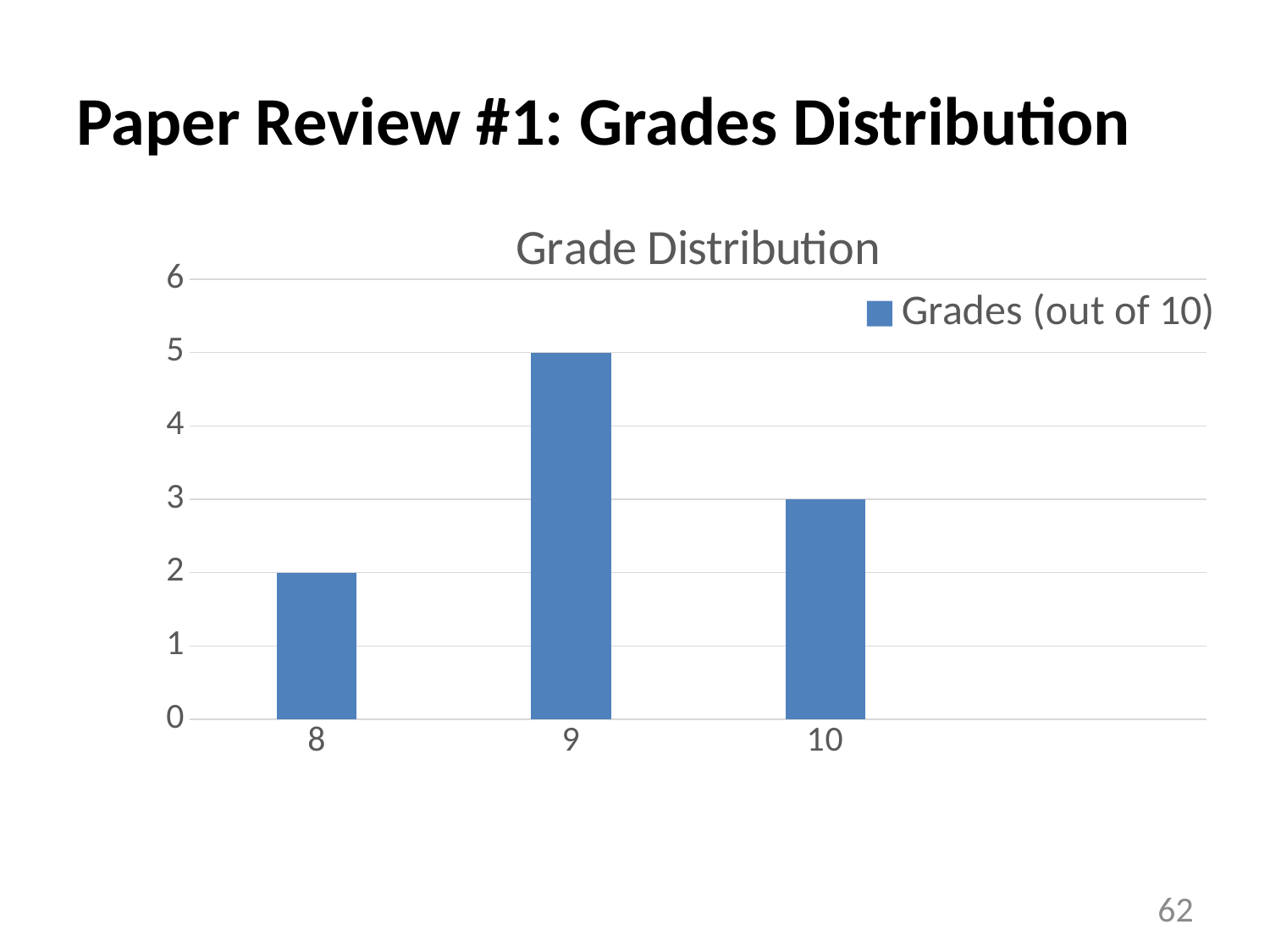
What kind of chart is shown on the slide? bar chart How many series does the legend list? 1 What is the value for grade 8 in the Grade Distribution chart? 2 Which grade has the lowest bar in the Grade Distribution chart? 8 Is the value for grade 9 greater or less than 4? greater What is the value for grade 10 in the Grade Distribution chart? 3 Which grade has the highest bar in the Grade Distribution chart? 9 What is the legend entry for the series in the chart? Grades (out of 10) How many grade categories are shown on the x axis? 3 Which is larger, the value for grade 8 or the value for grade 10? 10 What is the value for grade 9 in the Grade Distribution chart? 5 What is the difference between the values for grade 9 and grade 10? 2